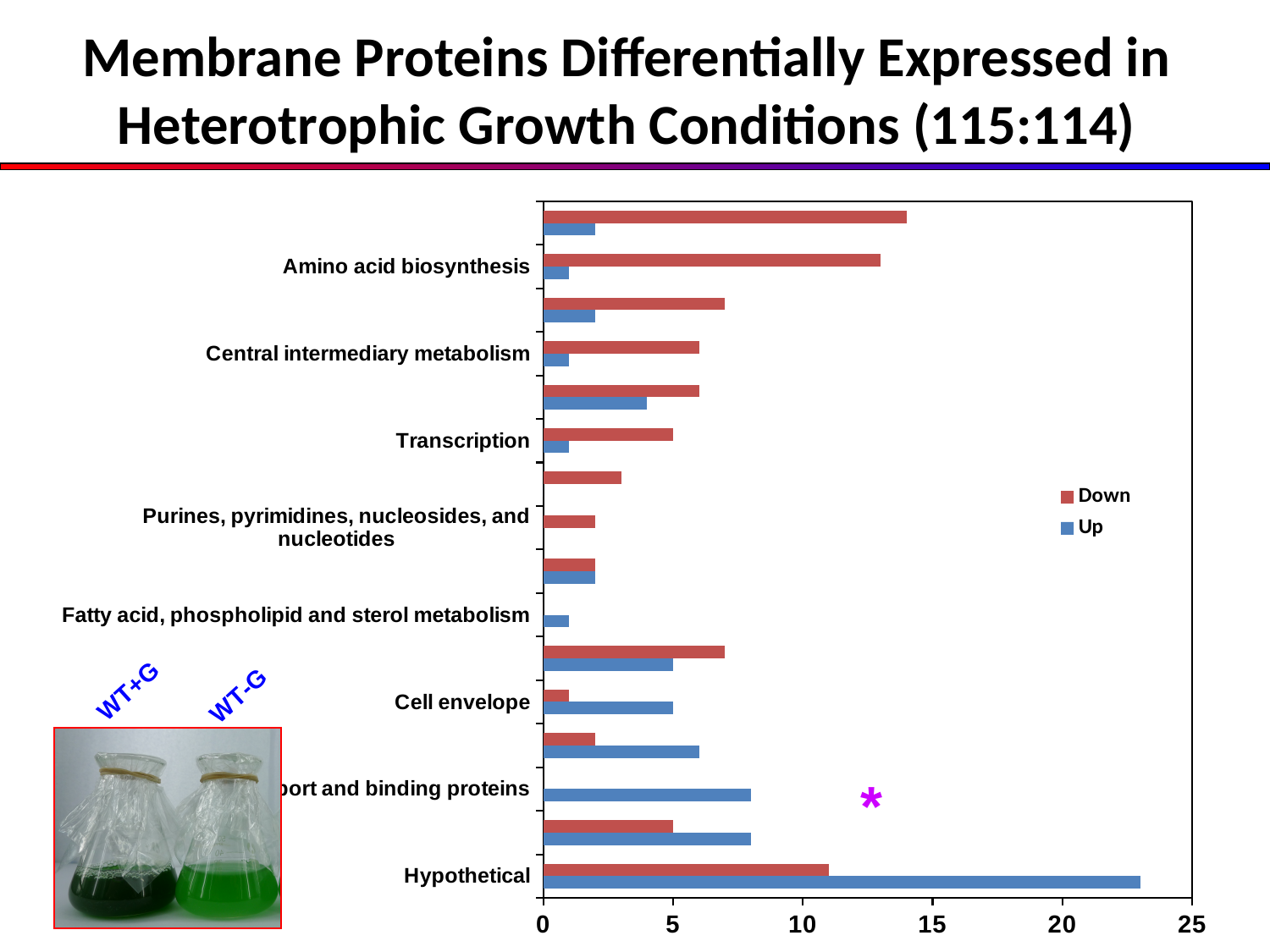
For Cell envelope, which is larger, the Up value or the Down value? Up Is the Down value for Central intermediary metabolism greater or less than 5? greater What kind of chart is shown on the slide? bar chart Which series does the red colour represent in the legend? Down Is the Up value for Hypothetical greater or less than 20? greater How many series does the legend list? 2 Which category has the longest bar in the chart? Hypothetical For Hypothetical, which is larger, the Up value or the Down value? Up Which series does the blue colour represent in the legend? Up For Transcription, which is larger, the Down value or the Up value? Down Is the Up value for Amino acid biosynthesis greater or less than 5? less